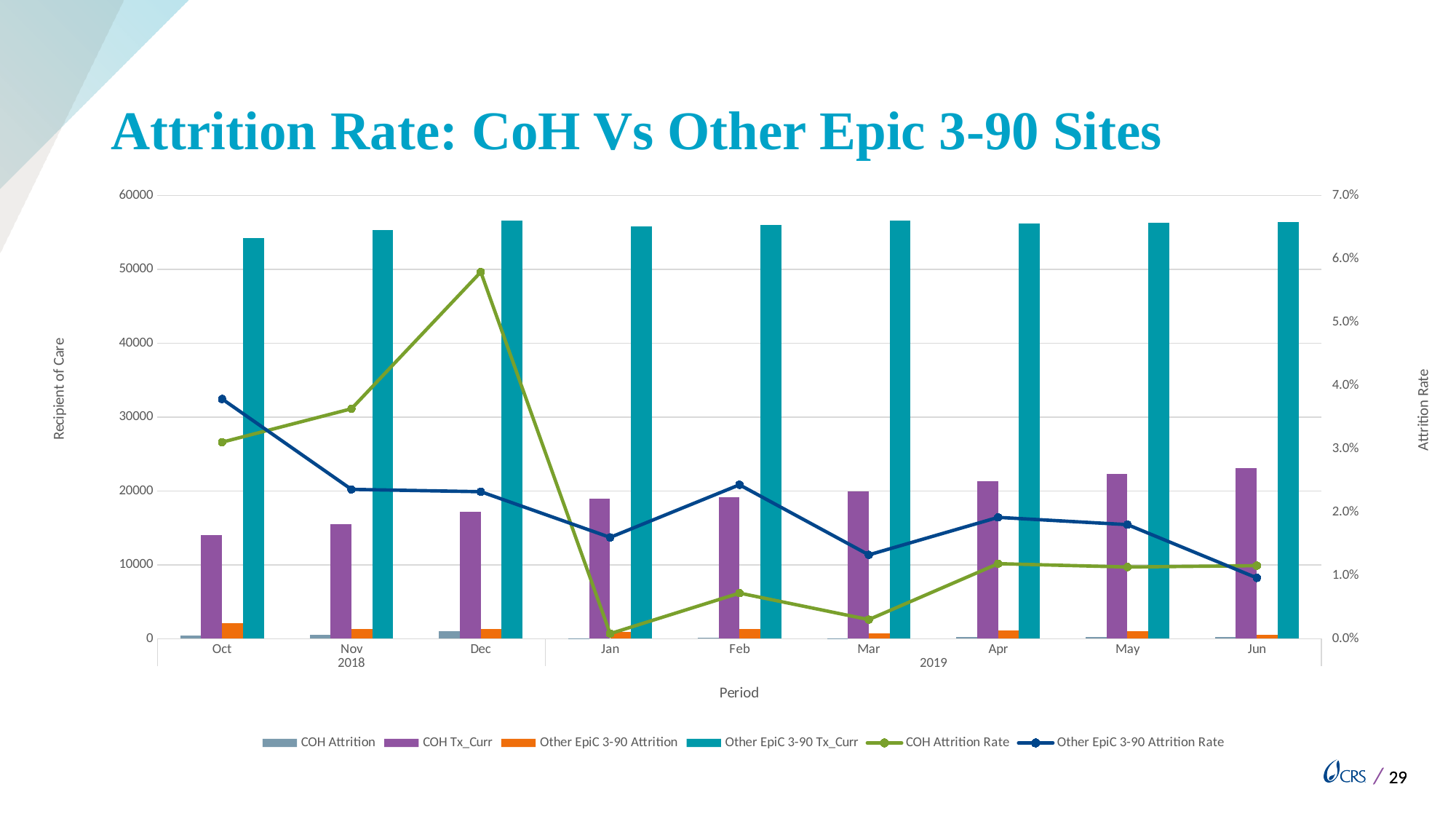
In which month is the COH Attrition Rate lowest? Jan Is the COH Tx_Curr value in Oct greater or less than 20000? less How many periods (months) are shown along the x axis? 9 Does the COH Tx_Curr series generally rise or fall from Oct to Jun? rise What kind of chart is shown on the slide? A combination bar and line chart How many series does the legend list? 6 What is the title of the right-hand vertical axis? Attrition Rate In which month is the COH Attrition Rate highest? Dec Is the COH Attrition Rate in Dec greater or less than 5.0%? greater In Oct, which is higher: the COH Attrition Rate or the Other EpiC 3-90 Attrition Rate? Other EpiC 3-90 Attrition Rate In which month is the Other EpiC 3-90 Attrition Rate highest? Oct Is the Other EpiC 3-90 Tx_Curr value in Oct greater or less than 50000? greater